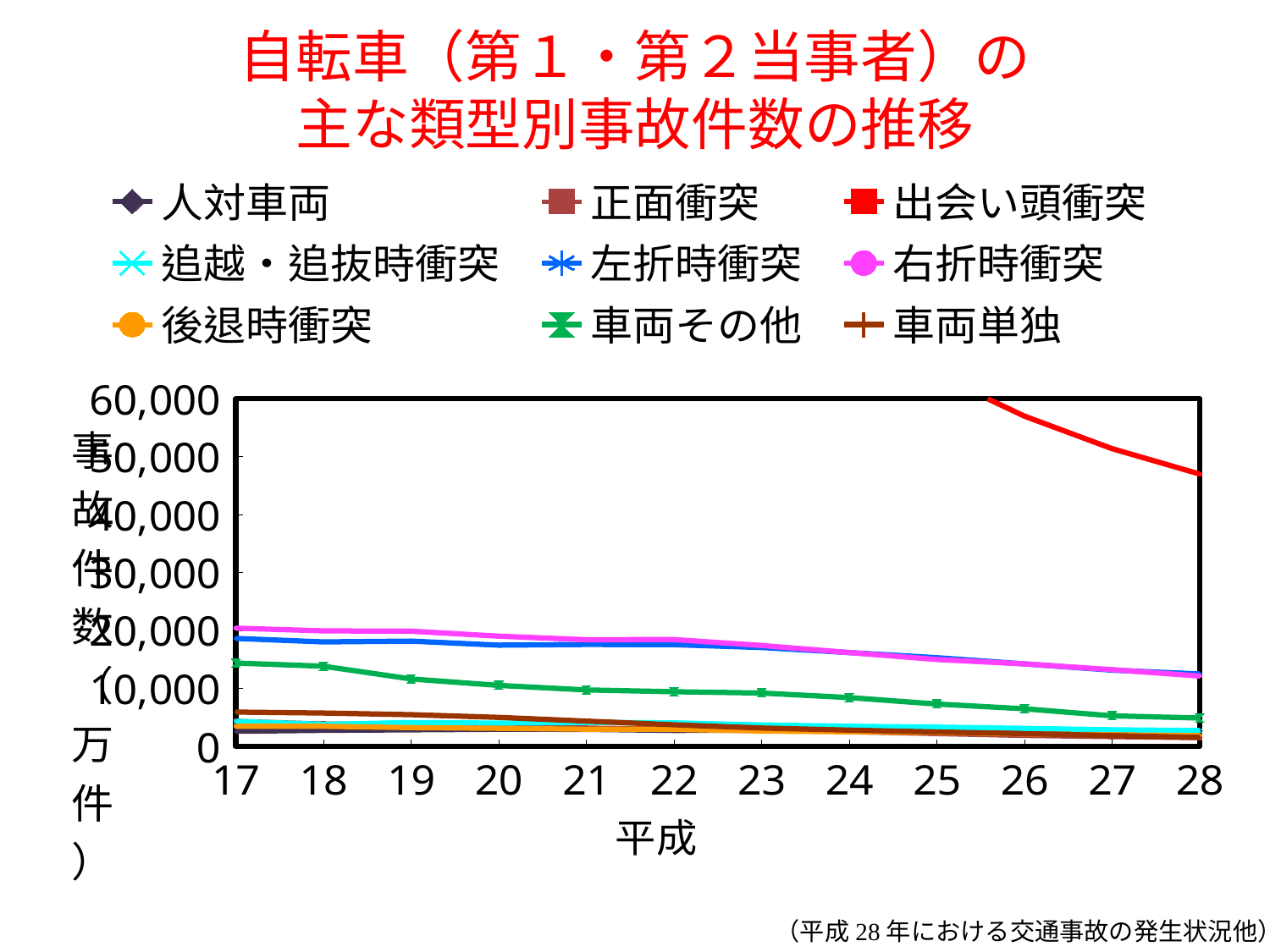
Does the value for 出会い頭衝突 rise or fall from 平成26 to 平成28? fall What kind of chart is shown on the slide? line chart How many years (points) are shown along the x axis? 12 What is the label of the x axis? 平成 In 平成28, which is larger: 出会い頭衝突 or 車両その他? 出会い頭衝突 Which series has the highest value in 平成28? 出会い頭衝突 How many series does the legend list? 9 Does the value for 車両その他 rise or fall from 平成17 to 平成28? fall What colour is the line for 出会い頭衝突? red Is the value for 右折時衝突 in 平成28 greater or less than 20,000? less Is the value for 車両その他 in 平成17 greater or less than 10,000? greater Is the value for 出会い頭衝突 in 平成28 greater or less than 40,000? greater